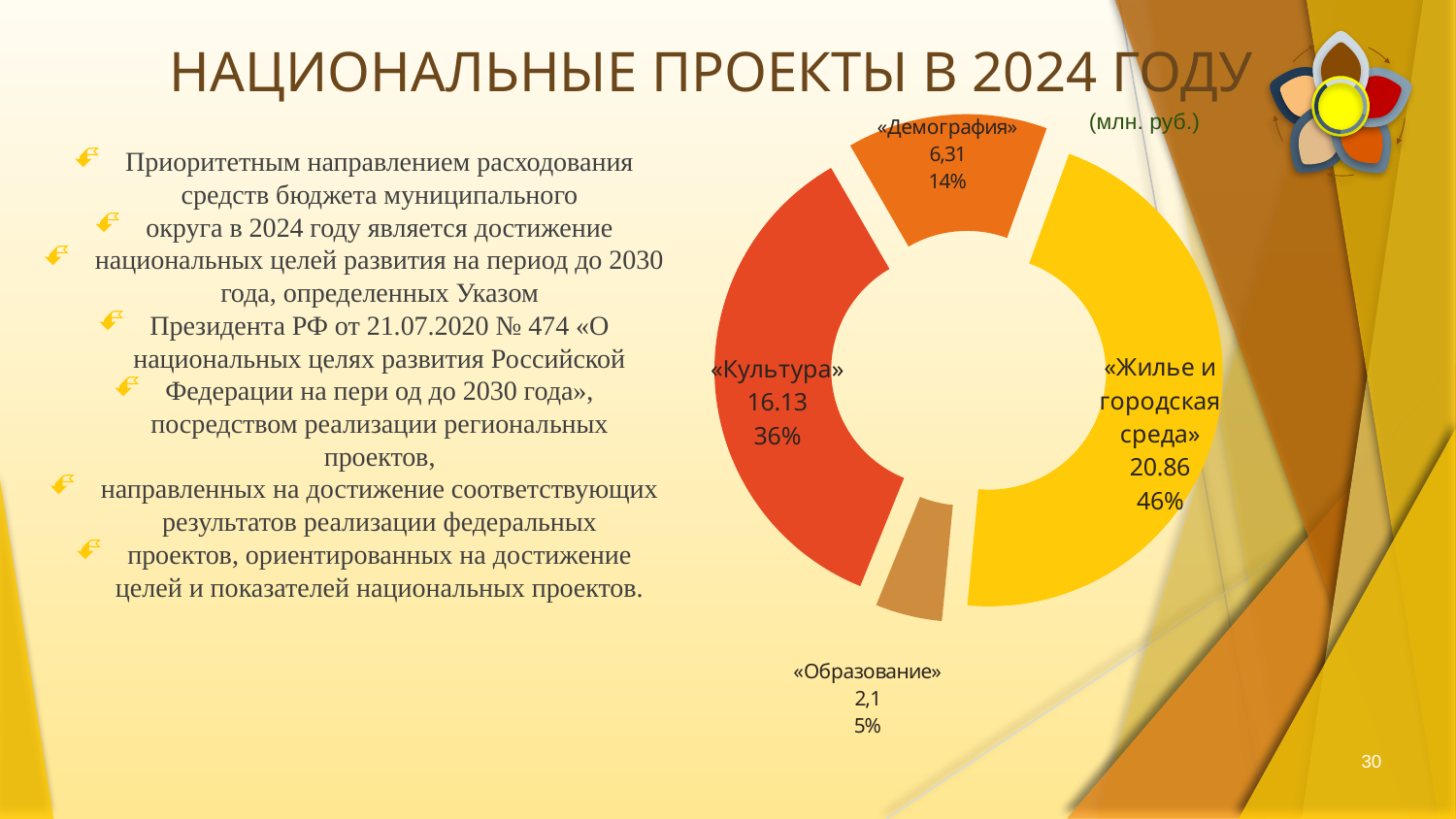
What is the difference between the values for «Жилье и городская среда» and «Культура»? 4.73 What is the value for «Культура»? 16.13 Which category has the largest share of the chart? «Жилье и городская среда» What percentage share does «Культура» have? 36% What type of chart is shown on the slide? Doughnut (pie) chart How many categories does the chart show? 4 Which category has the smallest share of the chart? «Образование» What is the value for «Жилье и городская среда»? 20.86 What is the value for «Образование»? 2,1 What is the value for «Демография»? 6,31 In what units are the chart values given? млн. руб. What percentage share does «Демография» have? 14%